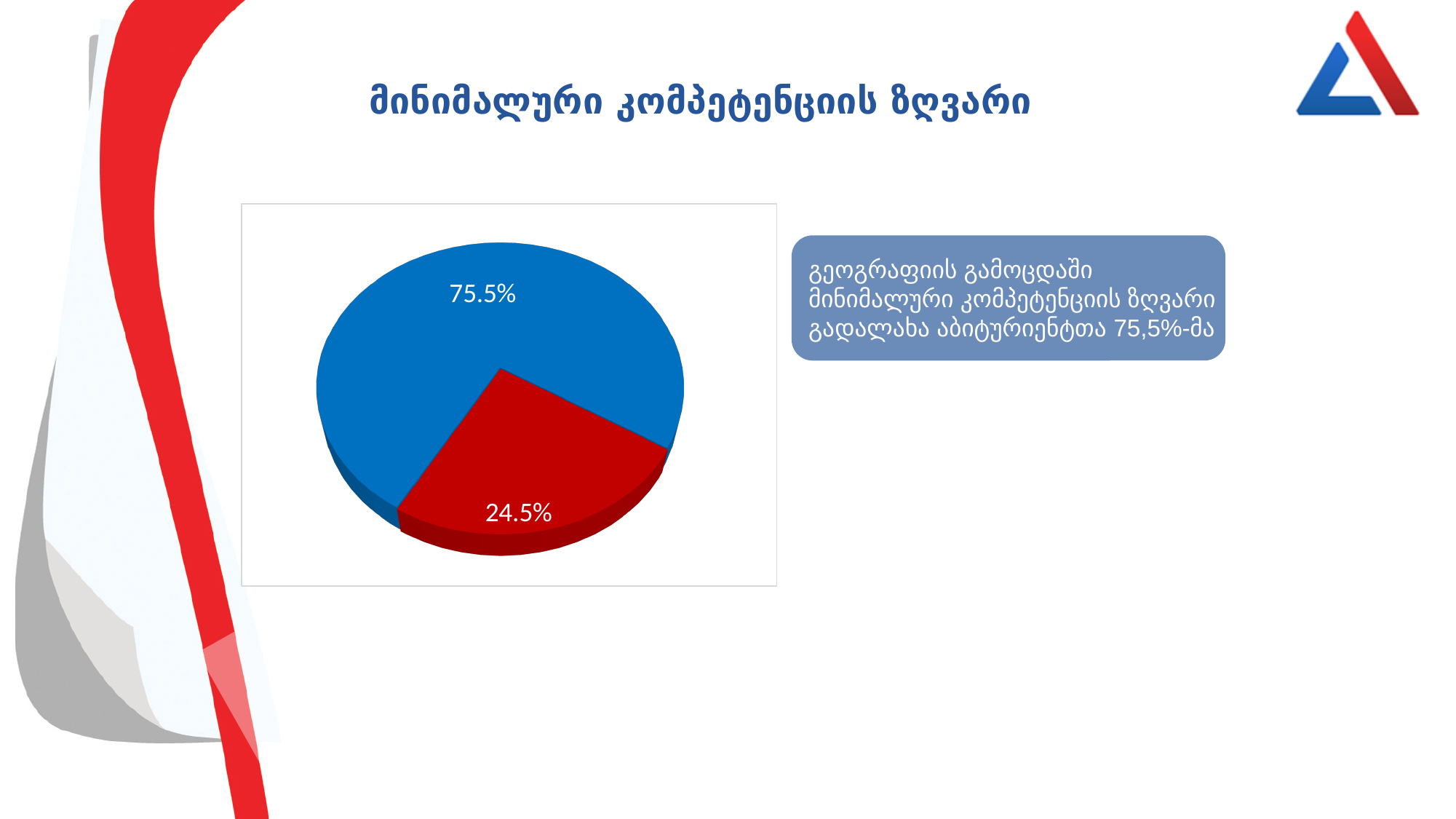
What percentage is shown on the red slice of the pie chart? 24.5% What is the difference between the blue slice and the red slice of the pie chart? 51.0% Which slice of the pie chart is the largest? the blue slice (75.5%) What colour is the larger slice of the pie chart? blue What share of the pie does the blue slice represent? 75.5% What do the two slices of the pie chart add up to? 100% Which slice of the pie chart is larger, the blue one or the red one? the blue one Which slice of the pie chart is the smallest? the red slice (24.5%) What share of the pie does the red slice represent? 24.5% How many slices does the pie chart have? 2 What type of chart is shown on the slide? pie chart What percentage is shown on the blue slice of the pie chart? 75.5%